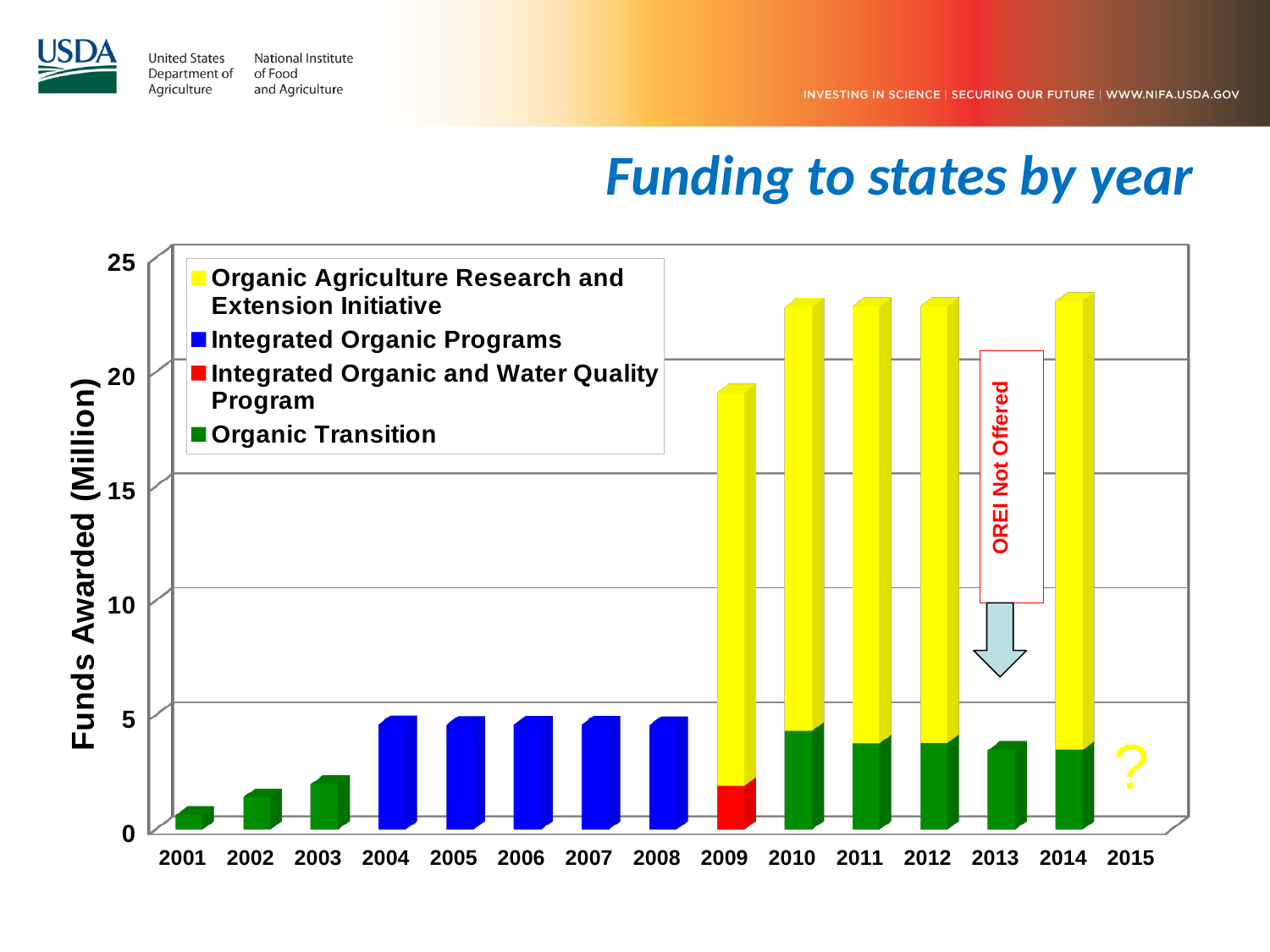
What kind of chart is shown on the slide? Stacked bar chart How many years are labelled along the x axis? 15 Which year has the lowest total funds awarded among the years with a bar? 2001 Which year has a larger total bar, 2009 or 2010? 2010 How many series does the legend list? 4 Is the total funds awarded for 2013 greater or less than 5? less Is the total funds awarded for 2010 greater or less than 20? greater Do the bars rise or fall from 2001 to 2003? Rise What is the title of the chart? Funding to states by year Is the value for 2001 greater or less than 5? less Which year is marked with the annotation "OREI Not Offered"? 2013